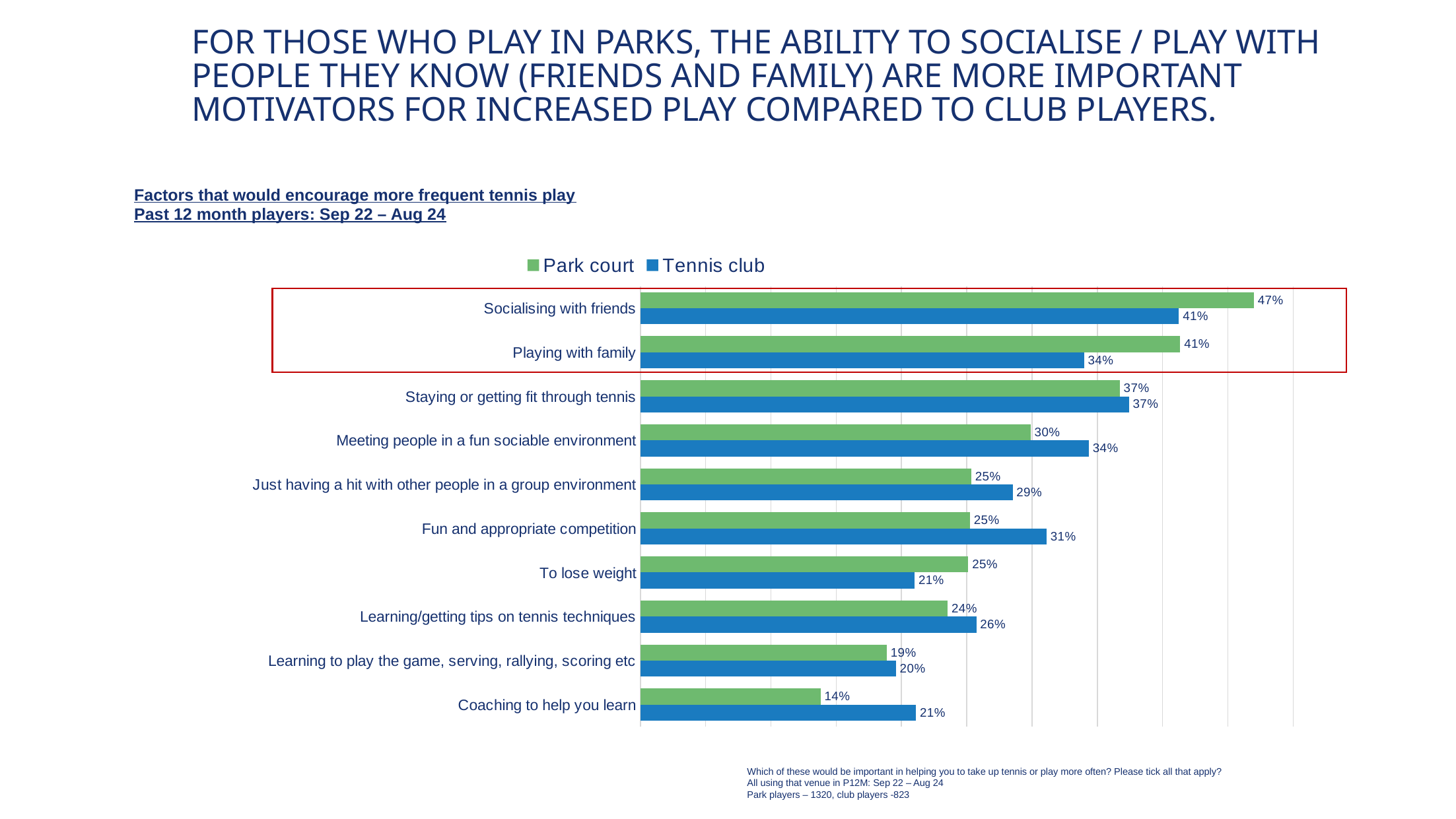
Which category has the lowest Park court value? Coaching to help you learn What is the Park court value for Socialising with friends? 47% What is the Tennis club value for Coaching to help you learn? 21% How many series does the legend list? 2 What kind of chart is shown on the slide? Bar chart Which colour represents the Tennis club series? Blue Which category has the highest Park court value? Socialising with friends How many categories are shown on the chart? 10 What is the Tennis club value for Fun and appropriate competition? 31% What is the Park court value for Learning to play the game, serving, rallying, scoring etc? 19% What is the difference between the Park court and Tennis club values for Playing with family? 7% For Meeting people in a fun sociable environment, which series has the larger value, Park court or Tennis club? Tennis club